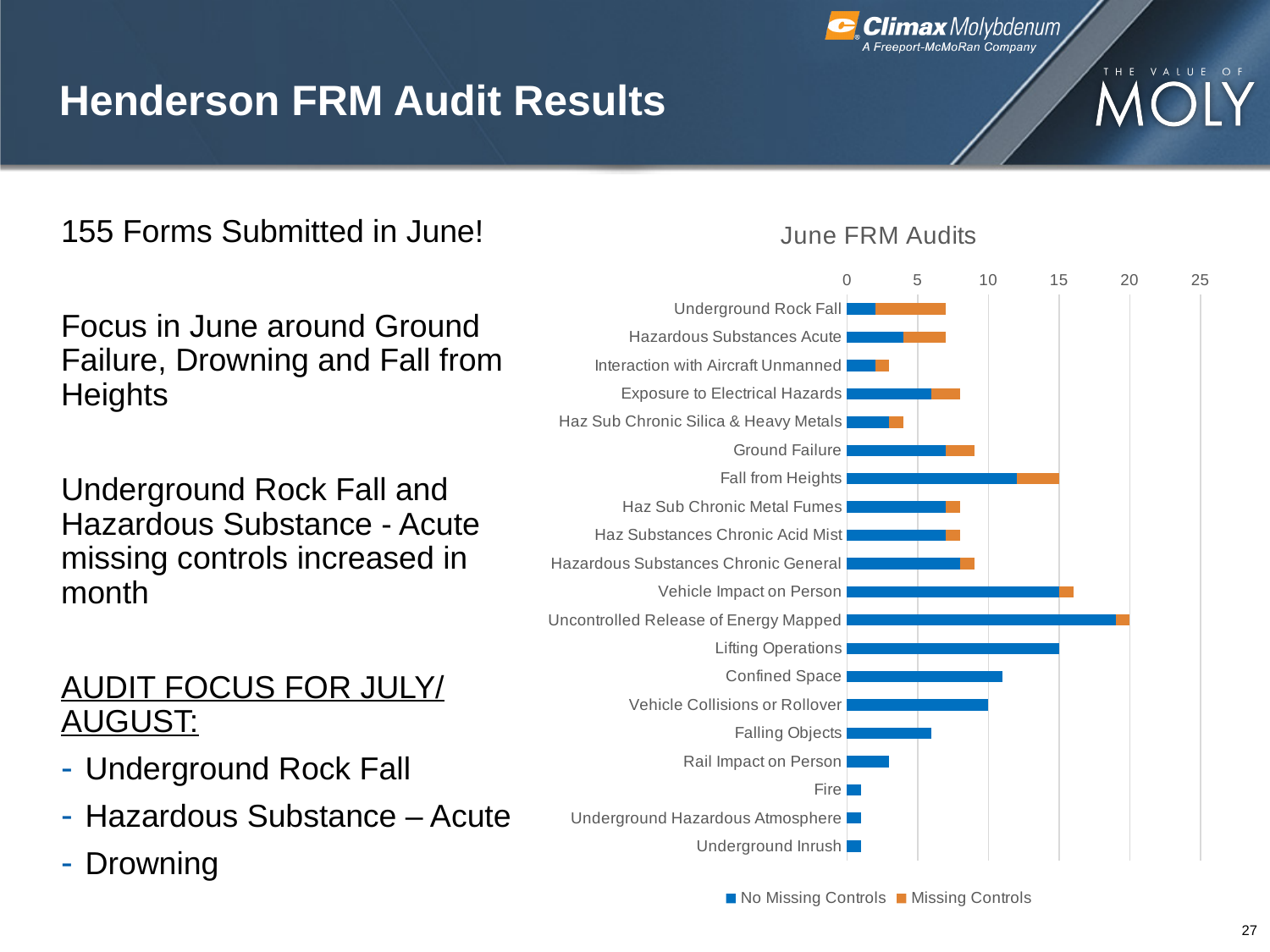
Which category has the longest total bar on the chart? Uncontrolled Release of Energy Mapped How many categories are plotted on the chart? 20 What are the two series named in the chart legend? No Missing Controls and Missing Controls Is the total bar for Uncontrolled Release of Energy Mapped greater or less than 15? greater Is the total bar for Fall from Heights greater or less than 10? greater What is the title of the chart? June FRM Audits Is the total bar for Confined Space greater or less than 10? greater How many series does the chart legend list? 2 Which has the longer total bar, Fall from Heights or Ground Failure? Fall from Heights What kind of chart is shown on the slide? bar chart Which has the longer total bar, Confined Space or Falling Objects? Confined Space